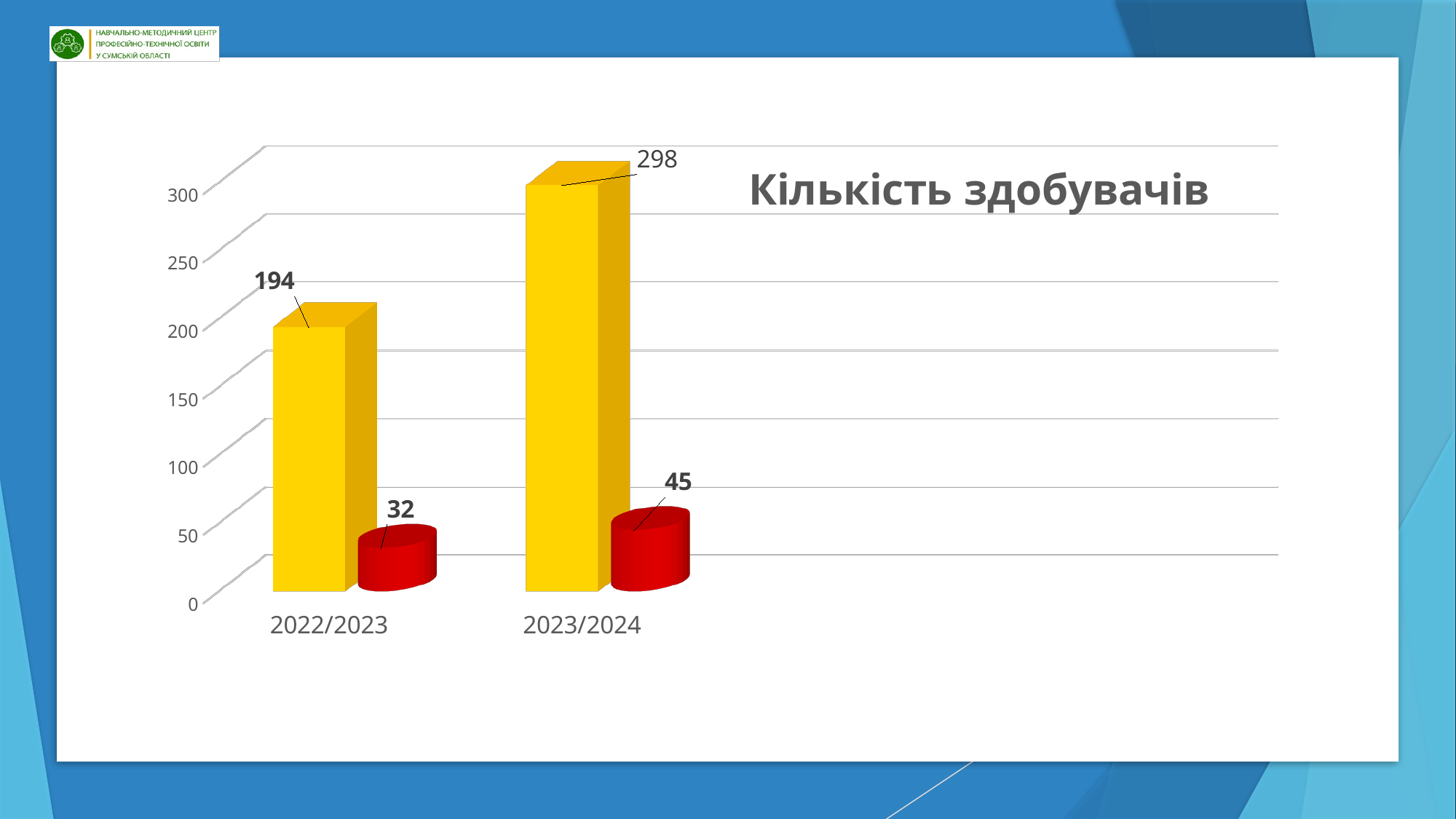
What is the value of the red bar for 2023/2024? 45 What is the value of the yellow bar for 2023/2024? 298 Which category has the lower value for the red series? 2022/2023 What is the difference between the red values for 2023/2024 and 2022/2023? 13 What kind of chart is shown on the slide? Bar chart Which is larger: the yellow bar for 2022/2023 or the red bar for 2023/2024? The yellow bar for 2022/2023 How many categories are shown on the x axis? 2 What is the value of the red bar for 2022/2023? 32 Which category has the higher value for the yellow series? 2023/2024 What is the title of the chart? Кількість здобувачів By how much does the yellow bar for 2023/2024 exceed the yellow bar for 2022/2023? 104 What is the value of the yellow bar for 2022/2023? 194